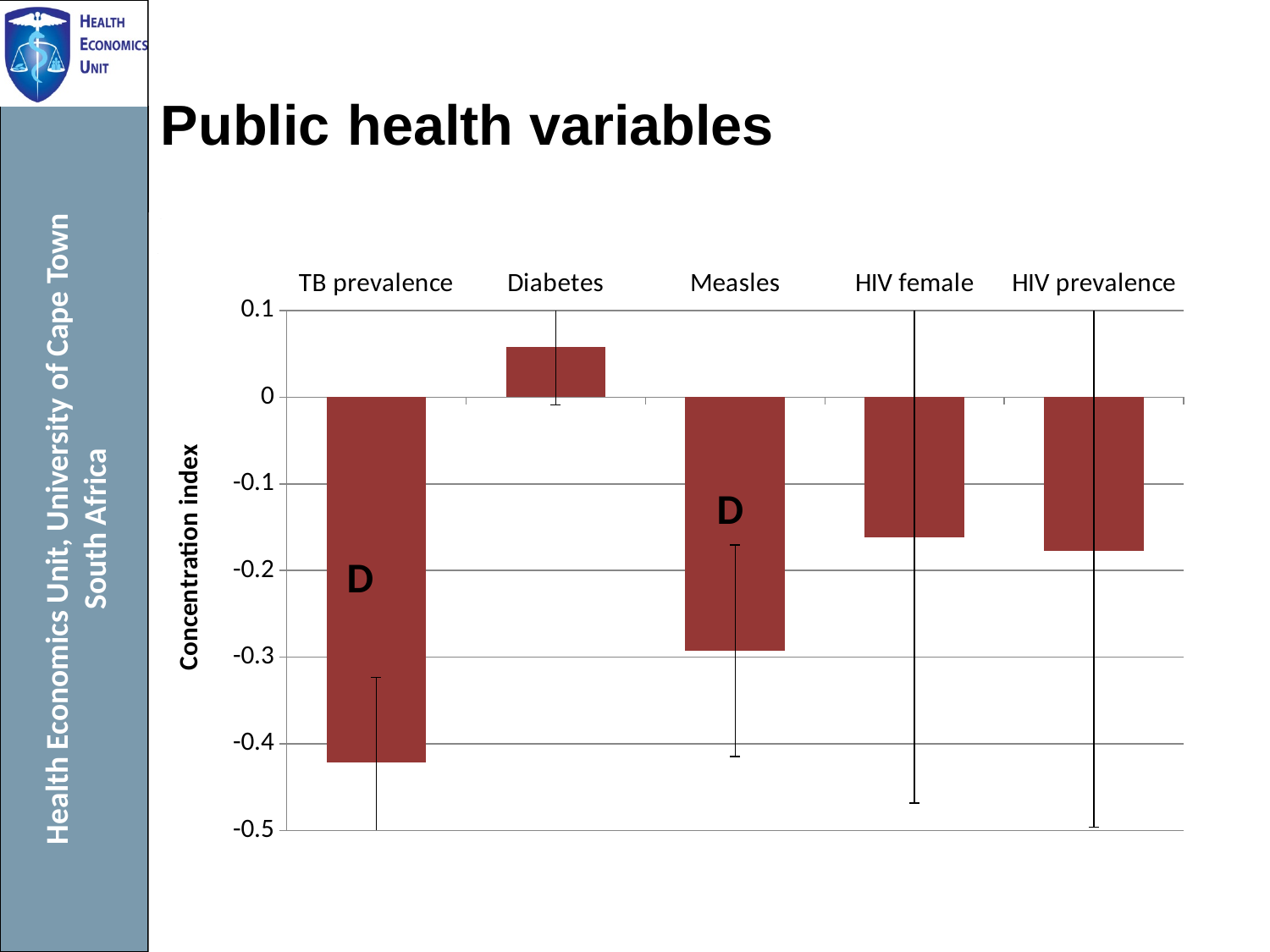
What kind of chart is shown on the slide? Bar chart Which is the only category with a positive concentration index? Diabetes Which category has the lowest concentration index? TB prevalence What is the title of the vertical axis? Concentration index Which has the larger concentration index, TB prevalence or Measles? Measles Is the value for HIV prevalence greater or less than -0.1? less Is the value for Diabetes greater or less than 0? greater How many categories are plotted in the chart? 5 Is the value for Measles greater or less than -0.2? less Which category has the highest concentration index? Diabetes